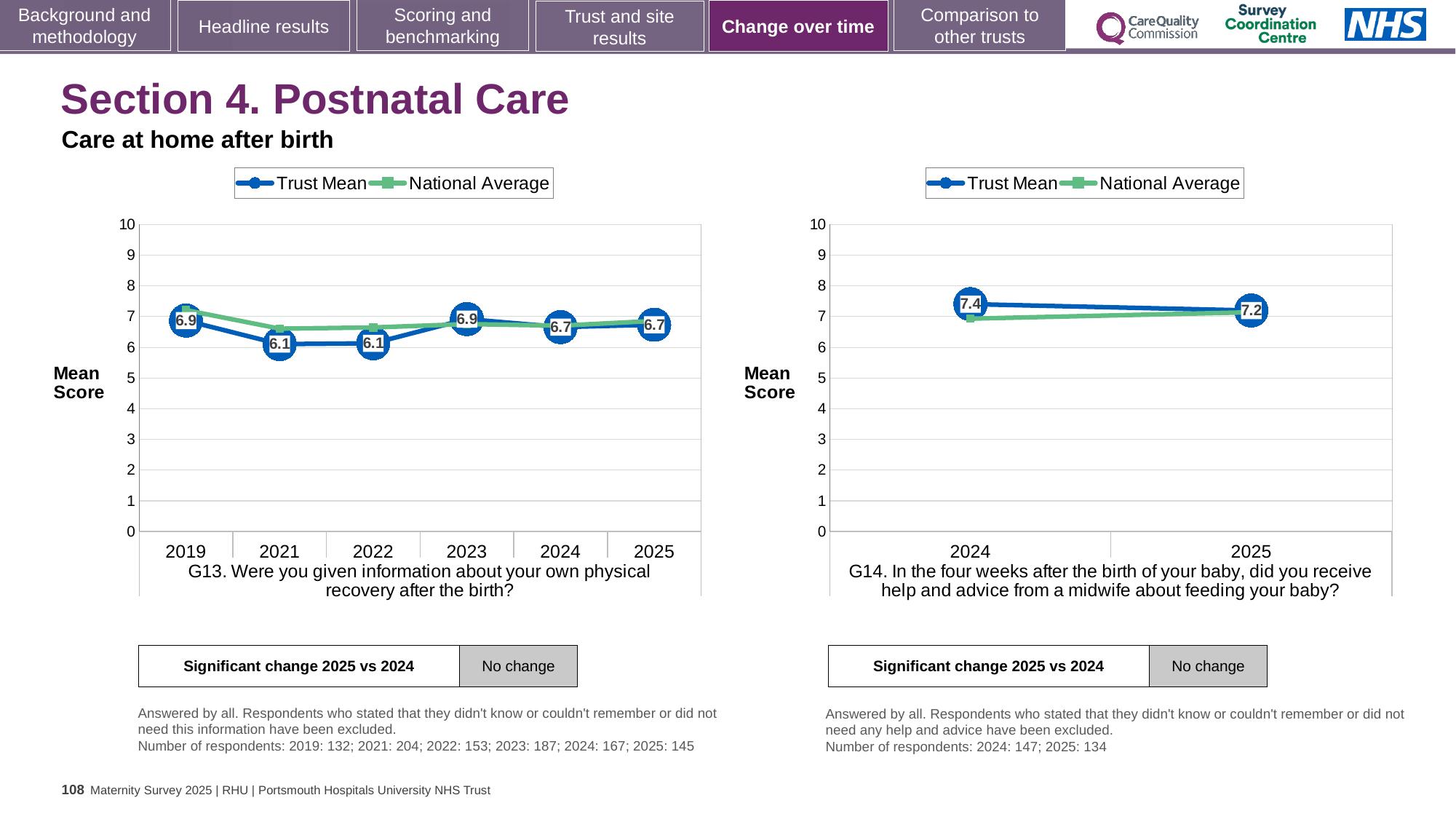
In the G14 chart on the right, what is the Trust Mean score for 2024? 7.4 In the G13 chart on the left, what is the difference between the Trust Mean scores for 2023 and 2022? 0.8 In the G13 chart on the left, is the Trust Mean score for 2019 larger or smaller than the score for 2021? larger What type of chart is the G13 chart on the left? Line chart How many years are plotted on the x axis of the G13 chart on the left? 6 In the G13 chart on the left, what is the Trust Mean score for 2025? 6.7 In the G14 chart on the right, which year has the higher Trust Mean score? 2024 In the G13 chart on the left, what is the Trust Mean score for 2021? 6.1 In the G13 chart on the left, is the National Average for 2021 greater or less than 7? less In the G14 chart on the right, what is the Trust Mean score for 2025? 7.2 How many series does the legend of the G14 chart on the right list? 2 In the G14 chart on the right, by how much did the Trust Mean score fall from 2024 to 2025? 0.2